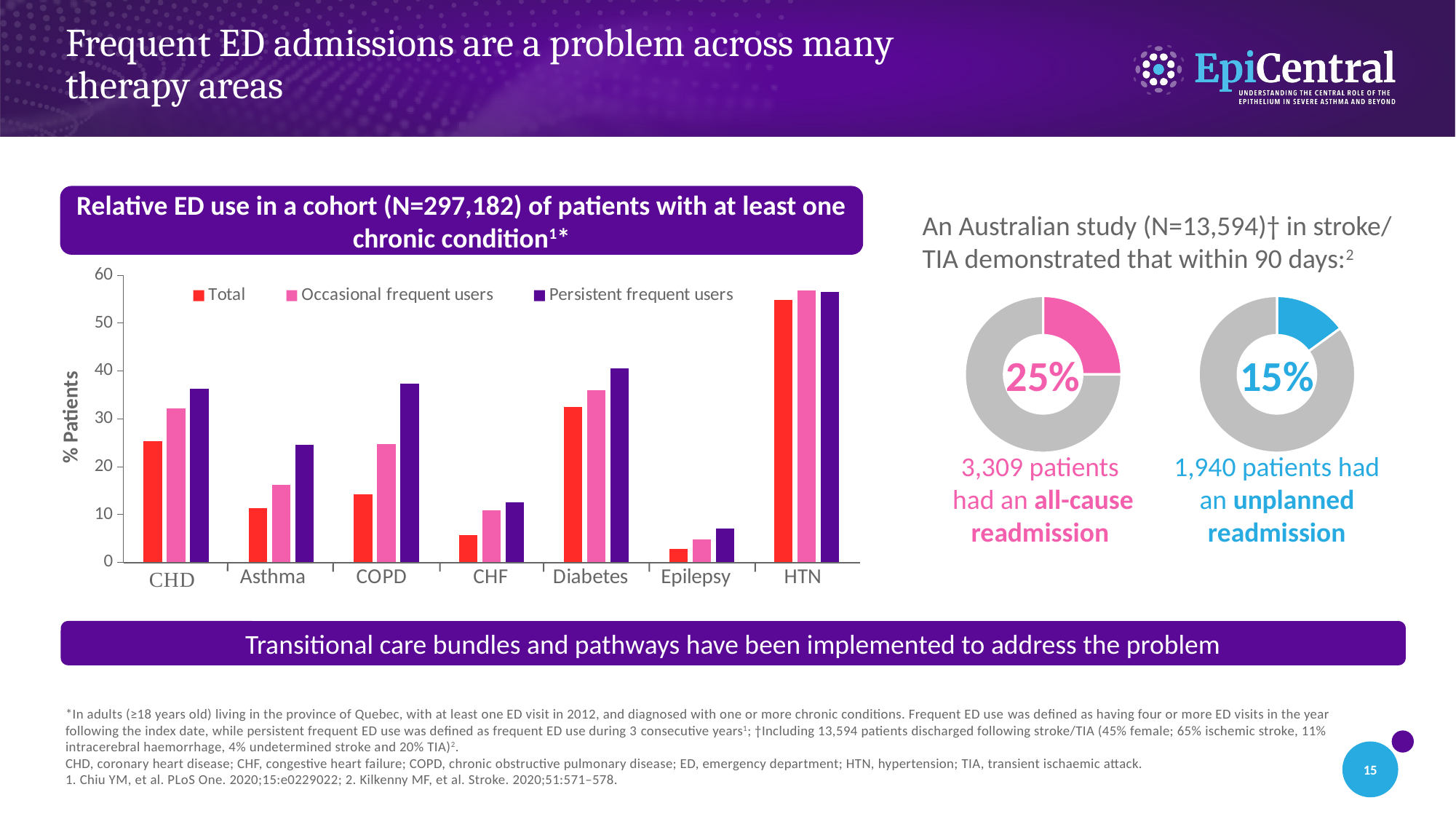
In the blue donut chart on the right of the slide, what share of patients had an unplanned readmission? 15% In the pink donut chart on the right of the slide, what share of patients had an all-cause readmission? 25% What kind of chart is the 'Relative ED use in a cohort' chart on the left of the slide? bar chart In the bar chart 'Relative ED use in a cohort', which is larger for COPD: the Total value or the Persistent frequent users value? Persistent frequent users In the bar chart 'Relative ED use in a cohort', which condition has the lowest value for Total? Epilepsy In the bar chart 'Relative ED use in a cohort', which condition has the highest value for Persistent frequent users? HTN In the bar chart 'Relative ED use in a cohort', is the Persistent frequent users value for CHF greater or less than 20? less In the bar chart 'Relative ED use in a cohort', is the Occasional frequent users value for Diabetes greater or less than 30? greater In the bar chart 'Relative ED use in a cohort', is the Total value for HTN greater or less than 50? greater In the bar chart 'Relative ED use in a cohort (N=297,182) of patients with at least one chronic condition', how many series does the legend list? 3 In the bar chart 'Relative ED use in a cohort (N=297,182) of patients with at least one chronic condition', how many chronic conditions are shown on the x axis? 7 In the bar chart 'Relative ED use in a cohort', what is the label of the y axis? % Patients